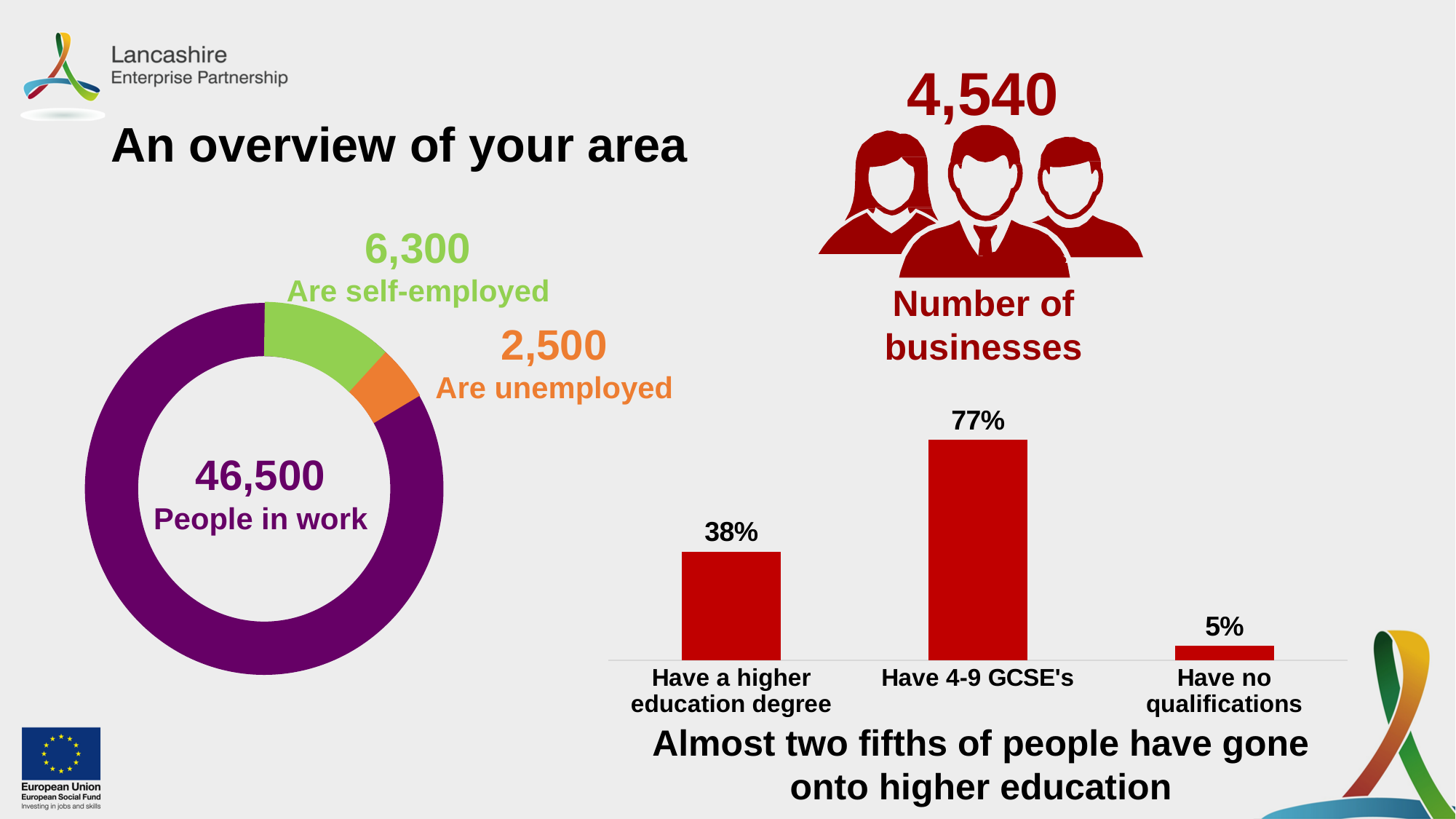
On the donut chart on the left, which segment is the smallest? Are unemployed On the donut chart on the left, which segment is the largest? People in work On the donut chart on the left, how many more people are self-employed than unemployed? 3,800 On the bar chart on the right, what percentage of people have a higher education degree? 38% What type of chart is shown on the right of the slide? Bar chart On the bar chart on the right, which category has the lowest value? Have no qualifications On the donut chart on the left, how many people are self-employed? 6,300 On the donut chart on the left, how many people are in work? 46,500 On the donut chart on the left, how many people are unemployed? 2,500 On the bar chart on the right, how many categories are shown? 3 On the bar chart on the right, what percentage of people have 4-9 GCSE's? 77% On the bar chart on the right, what is the difference between the share with 4-9 GCSE's and the share with a higher education degree? 39%